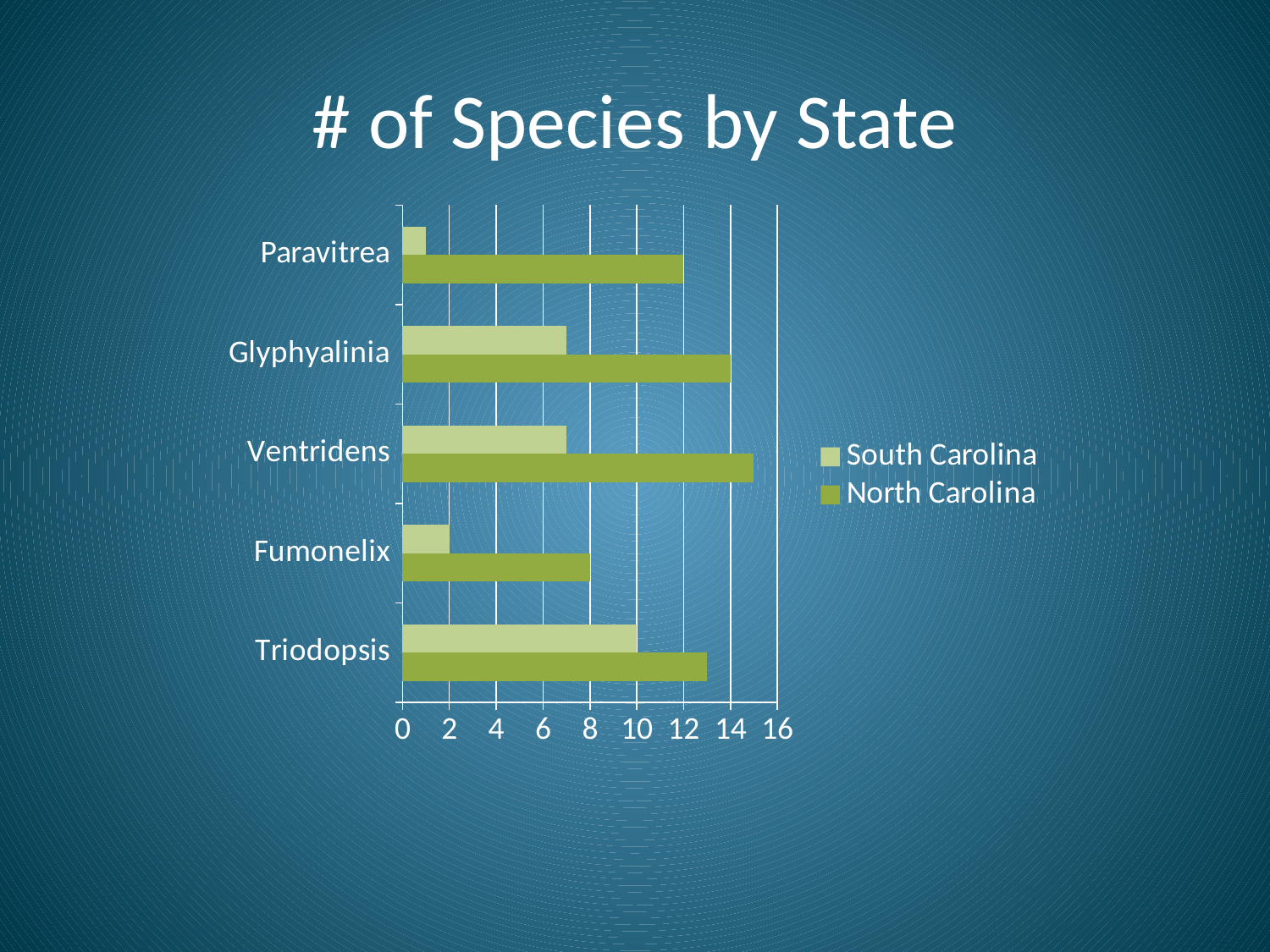
How many series does the legend list? 2 What is the South Carolina value for Triodopsis? 10 What kind of chart is shown on the slide? bar chart What is the North Carolina value for Fumonelix? 8 What is the North Carolina value for Paravitrea? 12 How many genera (categories) are shown on the chart? 5 What is the South Carolina value for Fumonelix? 2 Which genus has the highest North Carolina value? Ventridens Is the North Carolina value for Triodopsis greater or less than 12? greater What is the title of the chart? # of Species by State Which genus has the lowest South Carolina value? Paravitrea What is the difference between the North Carolina and South Carolina values for Fumonelix? 6